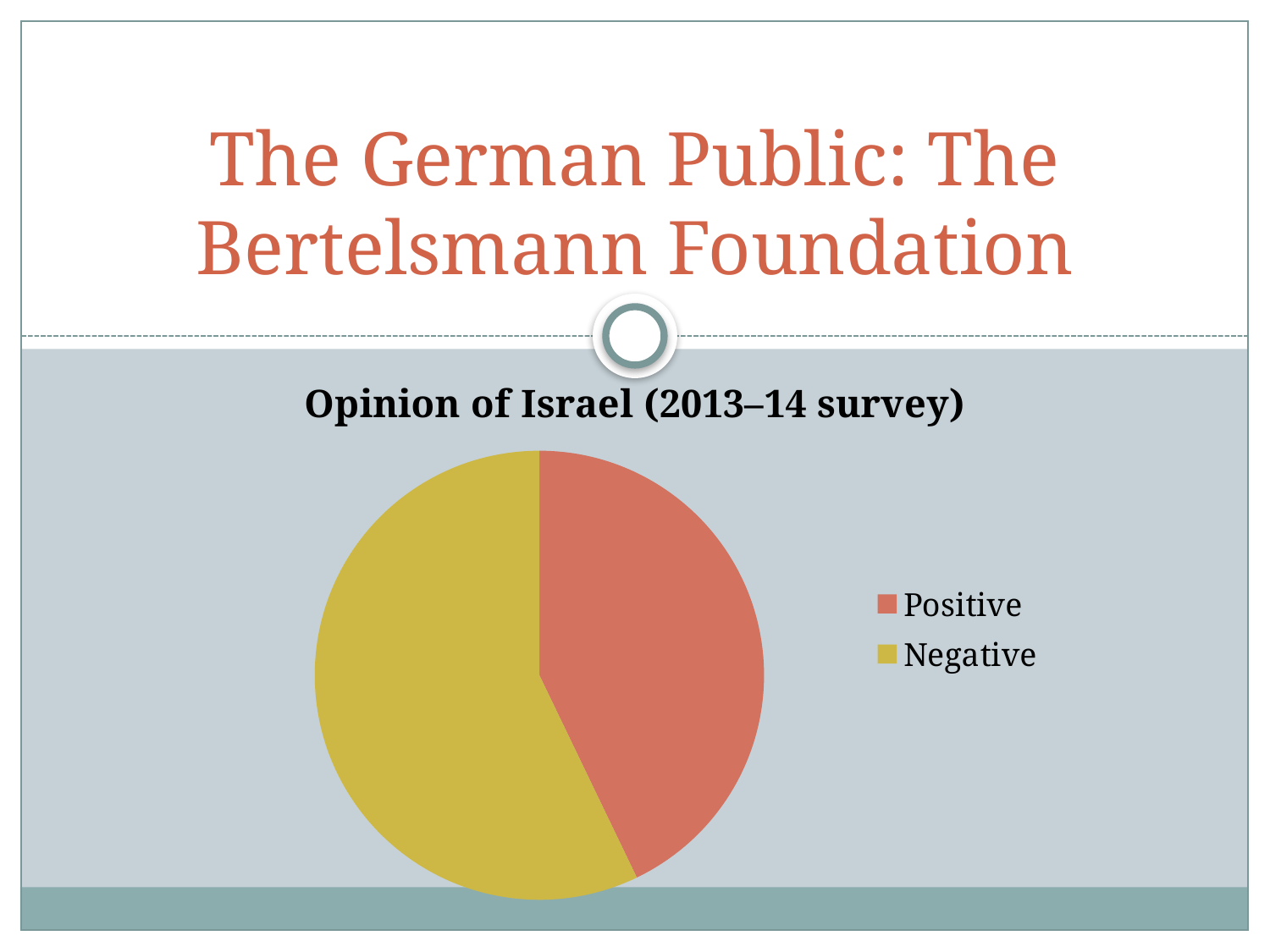
Is the Positive slice greater or less than half of the pie? less Which is larger, the Positive slice or the Negative slice? Negative Is the Negative slice greater or less than half of the pie? greater Which slice of the pie is the smallest? Positive What colour represents the Positive category in the pie chart? Red What kind of chart is shown on the slide? Pie chart How many entries does the legend list? 2 What is the title of the chart? Opinion of Israel (2013–14 survey) How many slices does the pie chart have? 2 Which slice of the pie is the largest? Negative